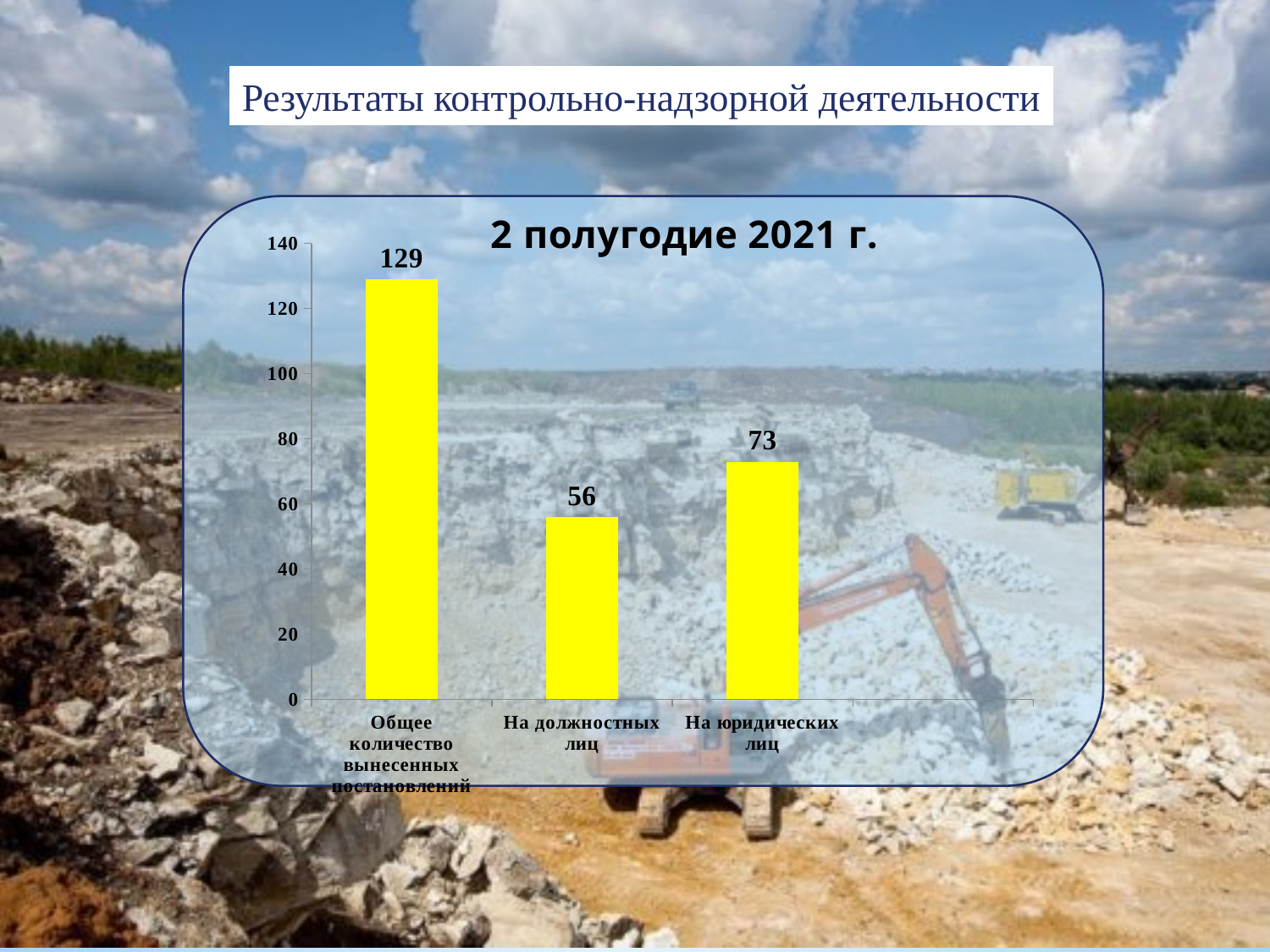
How many categories are shown in the chart? 3 What is the difference between the values for "На юридических лиц" and "На должностных лиц"? 17 What is the difference between the values for "Общее количество вынесенных постановлений" and "На юридических лиц"? 56 What is the value for "На должностных лиц"? 56 What kind of chart is shown on the slide? bar chart Which is larger, the value for "На должностных лиц" or the value for "На юридических лиц"? На юридических лиц What is the title of the chart? 2 полугодие 2021 г. What is the value for "На юридических лиц"? 73 Which category has the highest value? Общее количество вынесенных постановлений Is the value for "На должностных лиц" greater or less than 60? less Which category has the lowest value? На должностных лиц What is the value for "Общее количество вынесенных постановлений"? 129